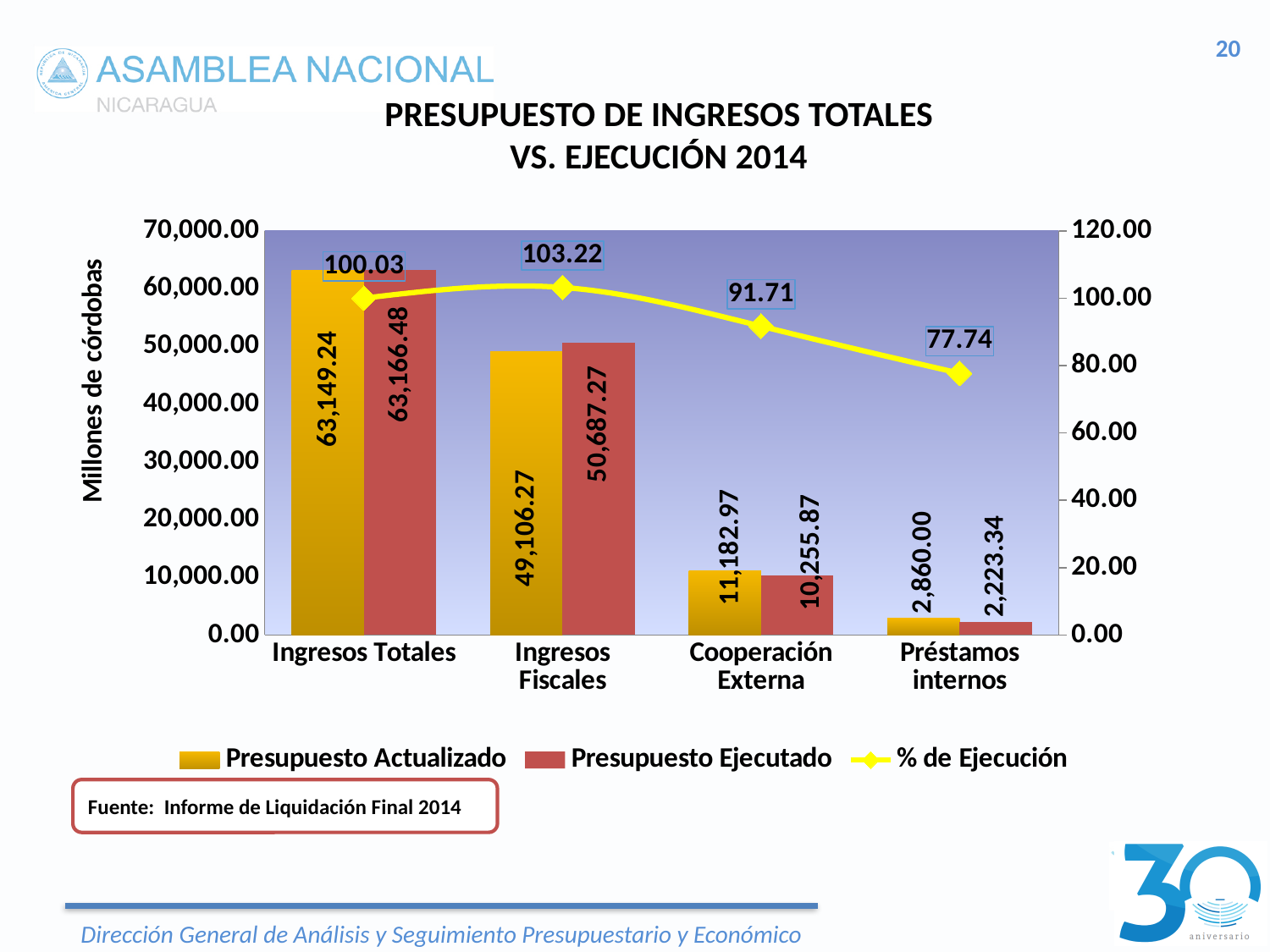
How many series does the legend list? 3 What is the difference between Presupuesto Ejecutado and Presupuesto Actualizado for Ingresos Fiscales? 1,581.00 What is the Presupuesto Ejecutado value for Ingresos Fiscales? 50,687.27 What is the Presupuesto Actualizado value for Ingresos Totales? 63,149.24 Which category has the lowest Presupuesto Actualizado? Préstamos internos Which is larger for Cooperación Externa, Presupuesto Actualizado or Presupuesto Ejecutado? Presupuesto Actualizado Which category has the highest % de Ejecución? Ingresos Fiscales How many categories are shown on the x axis? 4 Does the % de Ejecución line rise or fall from Ingresos Fiscales to Préstamos internos? Fall What is the % de Ejecución for Cooperación Externa? 91.71 What kind of chart is shown on the slide? Bar chart with a line What is the Presupuesto Ejecutado value for Préstamos internos? 2,223.34